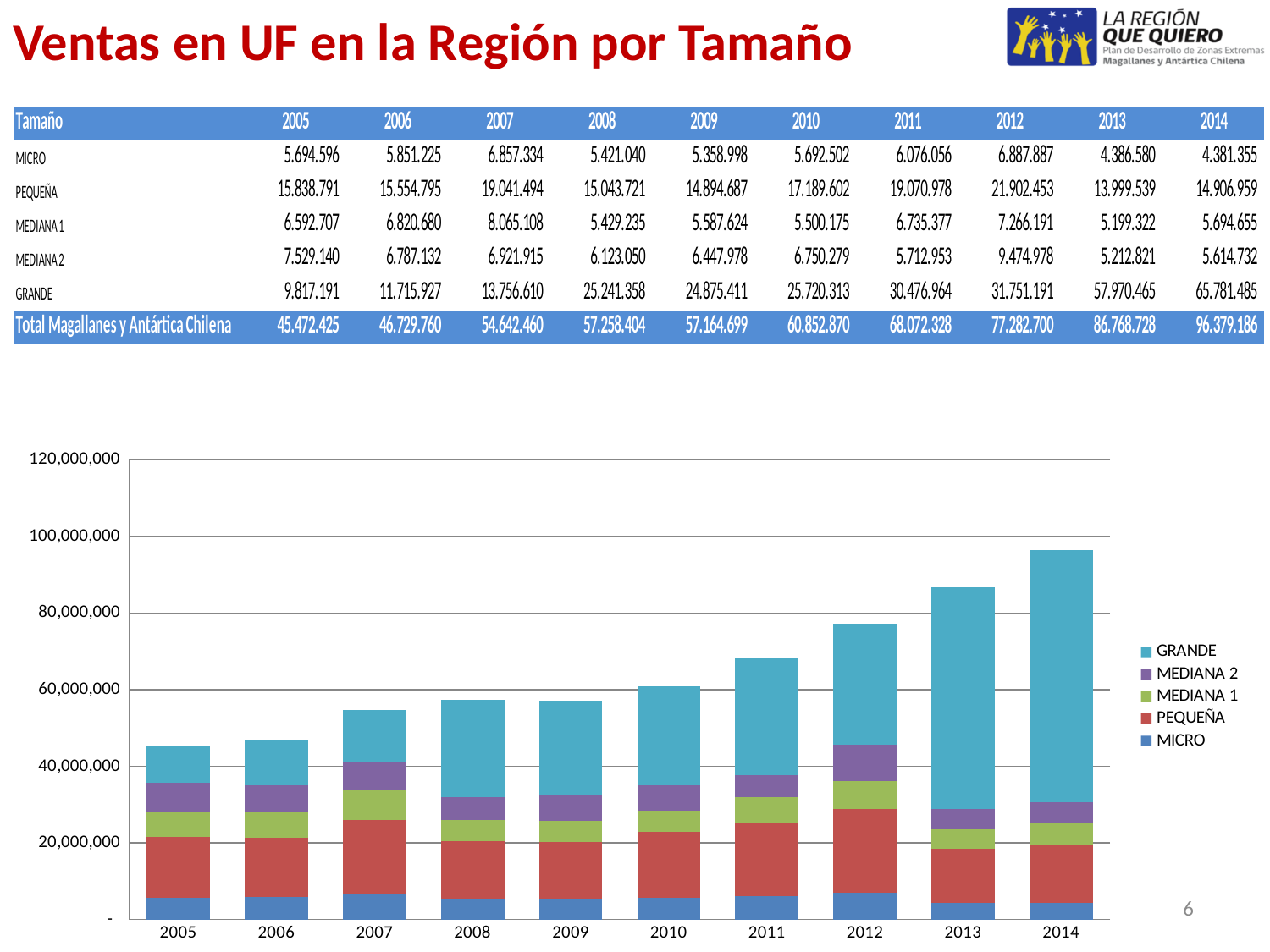
Is the total stacked bar for 2014 greater or less than 80,000,000? greater Which year has the highest total stacked bar in the chart? 2014 Which year has the lowest total stacked bar in the chart? 2005 According to the table, what is the Total Magallanes y Antártica Chilena for 2014? 96.379.186 Is the total stacked bar for 2005 greater or less than 60,000,000? less Which year has the larger total stacked bar, 2012 or 2013? 2013 Which series appears at the top of each stacked bar in the chart? GRANDE How many years are shown along the x axis of the chart? 10 What kind of chart is shown on the slide? bar chart Do the total stacked bar values rise or fall from 2005 to 2014? rise How many series does the chart's legend list? 5 According to the table, what is the GRANDE value for 2013? 57.970.465